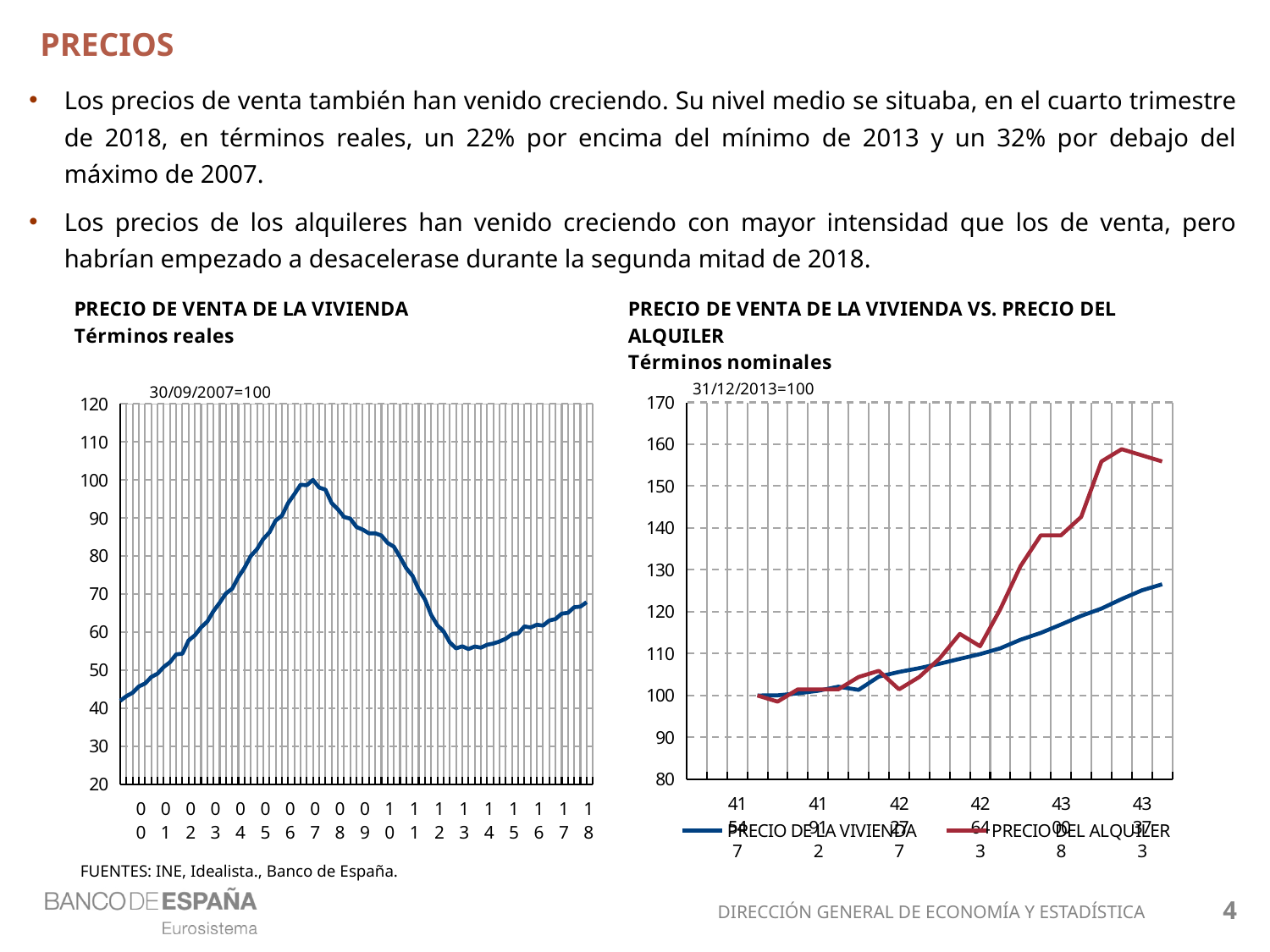
In the right chart, is the final value of PRECIO DE LA VIVIENDA greater or less than 130? less In the left chart, in which year does the line reach its highest value? 07 In the left chart, is the value in year 13 greater or less than 60? less In the right chart, is the final value of PRECIO DEL ALQUILER greater or less than 150? greater In the left chart, does the line rise or fall between year 07 and year 13? fall What base period is stated for the index in the right chart? 31/12/2013=100 In the right chart, what are the two series named in the legend? PRECIO DE LA VIVIENDA and PRECIO DEL ALQUILER What kind of chart is the left chart, 'PRECIO DE VENTA DE LA VIVIENDA'? Line chart In the left chart, in which year is the line at its lowest value? 00 In the right chart, which series is higher at the end of the period, PRECIO DE LA VIVIENDA or PRECIO DEL ALQUILER? PRECIO DEL ALQUILER How many series does the legend of the right chart, 'PRECIO DE VENTA DE LA VIVIENDA VS. PRECIO DEL ALQUILER', list? 2